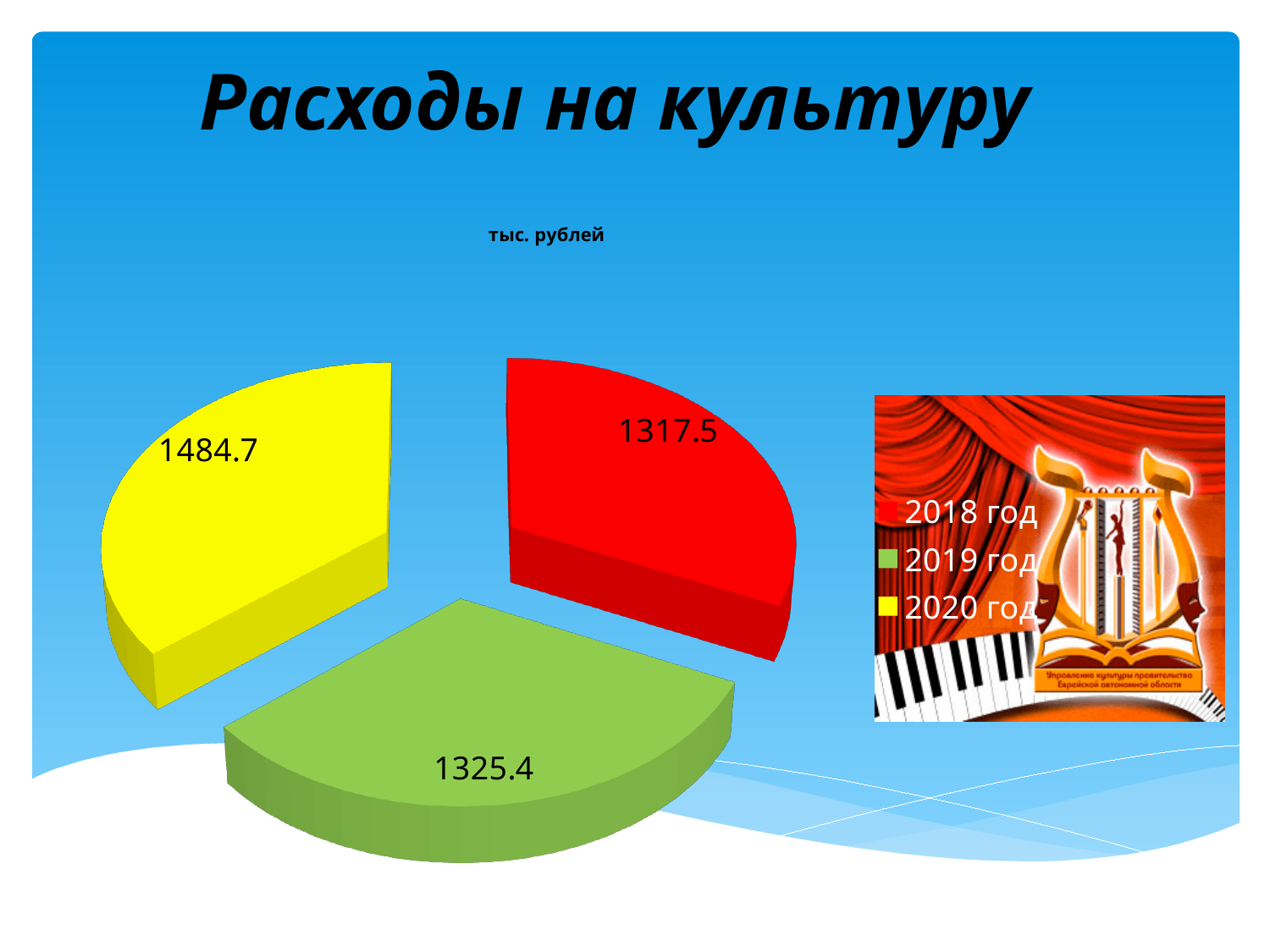
What is the value for 2018 год in the pie chart? 1317.5 Which year has the largest slice in the pie chart? 2020 год What is the difference between the values for 2020 год and 2018 год? 167.2 What type of chart is shown on the slide? Pie chart What colour is the slice for 2020 год? Yellow What is the value for 2019 год in the pie chart? 1325.4 Which year has the smallest value in the pie chart? 2018 год What is the difference between the values for 2019 год and 2018 год? 7.9 What is the title of the slide containing the pie chart? Расходы на культуру Which is larger, the value for 2019 год or the value for 2018 год? 2019 год What is the value for 2020 год in the pie chart? 1484.7 How many slices does the pie chart have? 3